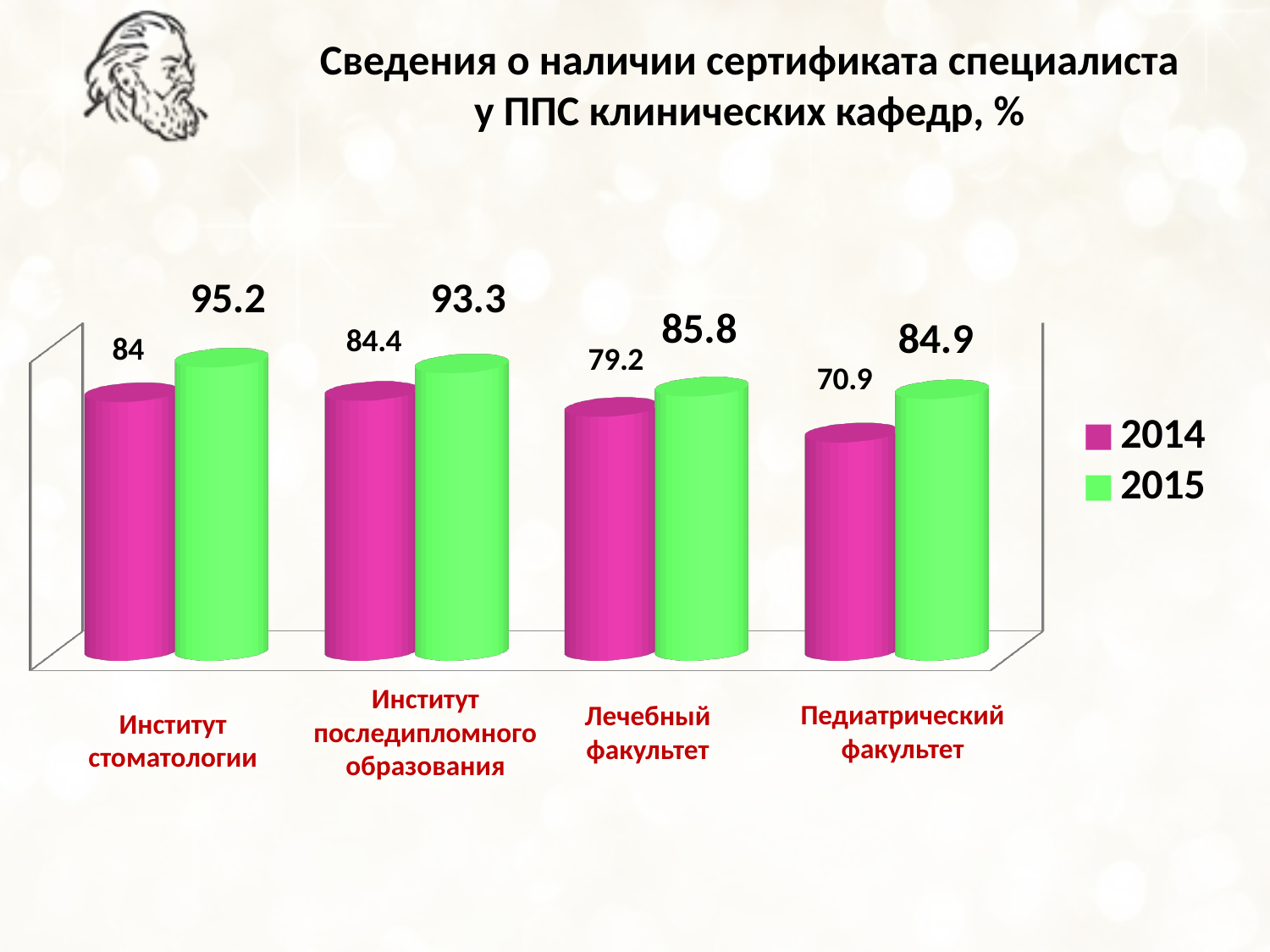
What is the 2014 value for Лечебный факультет? 79.2 How many categories are shown on the x axis? 4 Which category has the lowest 2014 value? Педиатрический факультет What is the 2015 value for Педиатрический факультет? 84.9 What kind of chart is shown on the slide? Bar chart Which category has the highest 2015 value? Институт стоматологии What is the difference between the 2015 values for Институт стоматологии and Институт последипломного образования? 1.9 How many series does the legend list? 2 What is the difference between the 2015 and 2014 values for Педиатрический факультет? 14 Which is larger: the 2014 value for Институт последипломного образования or the 2014 value for Лечебный факультет? Институт последипломного образования Which series is shown in green in the legend? 2015 What is the 2014 value for Институт стоматологии? 84